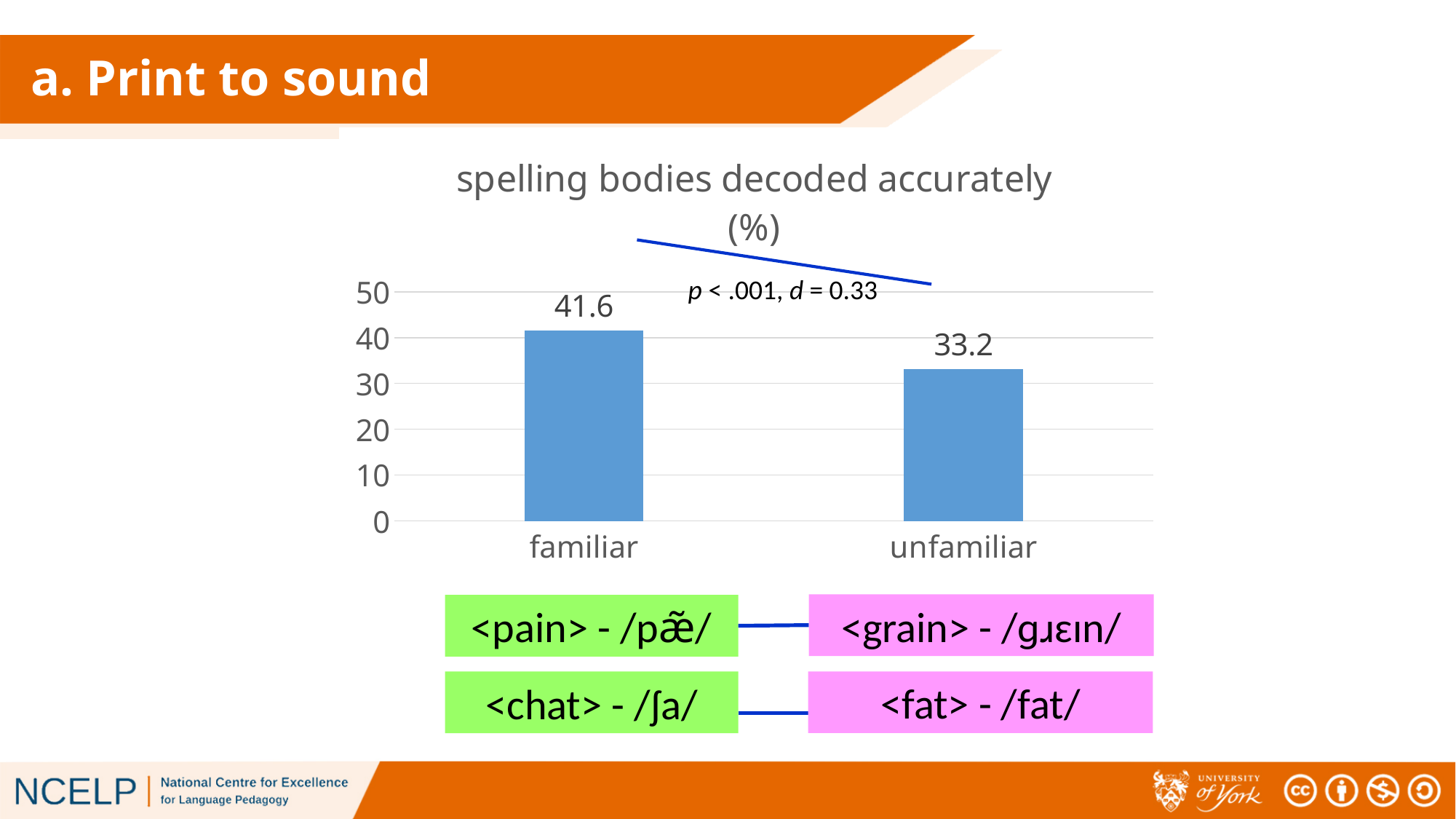
What is the title of the chart? spelling bodies decoded accurately (%) Is the value for familiar greater or less than 40? greater What is the value for the unfamiliar category? 33.2 What kind of chart is shown? bar chart Which category has the lowest value? unfamiliar What is the difference between the familiar and unfamiliar values? 8.4 How many categories are shown on the x axis? 2 Which category has the highest value? familiar What is the value for the familiar category? 41.6 What is the maximum value shown on the y axis? 50 Which is larger, the value for familiar or the value for unfamiliar? familiar Is the value for unfamiliar greater or less than 40? less